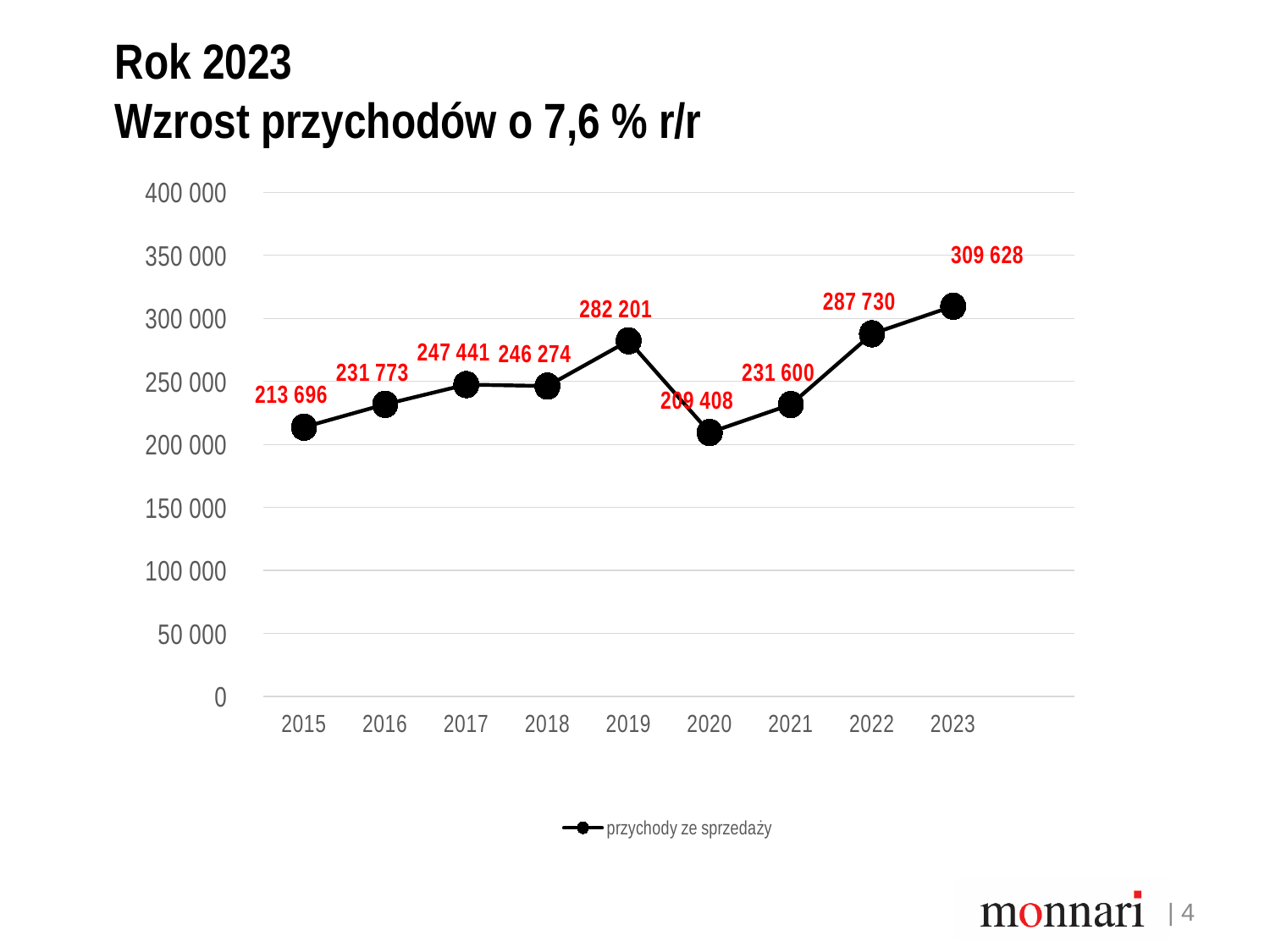
What is the value for 2017 in the chart? 247 441 What series name does the legend show? przychody ze sprzedaży What is the value for 2020 in the chart? 209 408 Which year has the highest value in the chart? 2023 What kind of chart is shown on the slide? line chart Which year has the lowest value in the chart? 2020 Is the value for 2020 greater or less than 250 000? less Which is larger, the value for 2015 or the value for 2018? 2018 What is the difference between the values for 2019 and 2020? 72 793 What is the value for 2023 in the chart? 309 628 What is the difference between the values for 2023 and 2022? 21 898 How many years are plotted on the x axis? 9